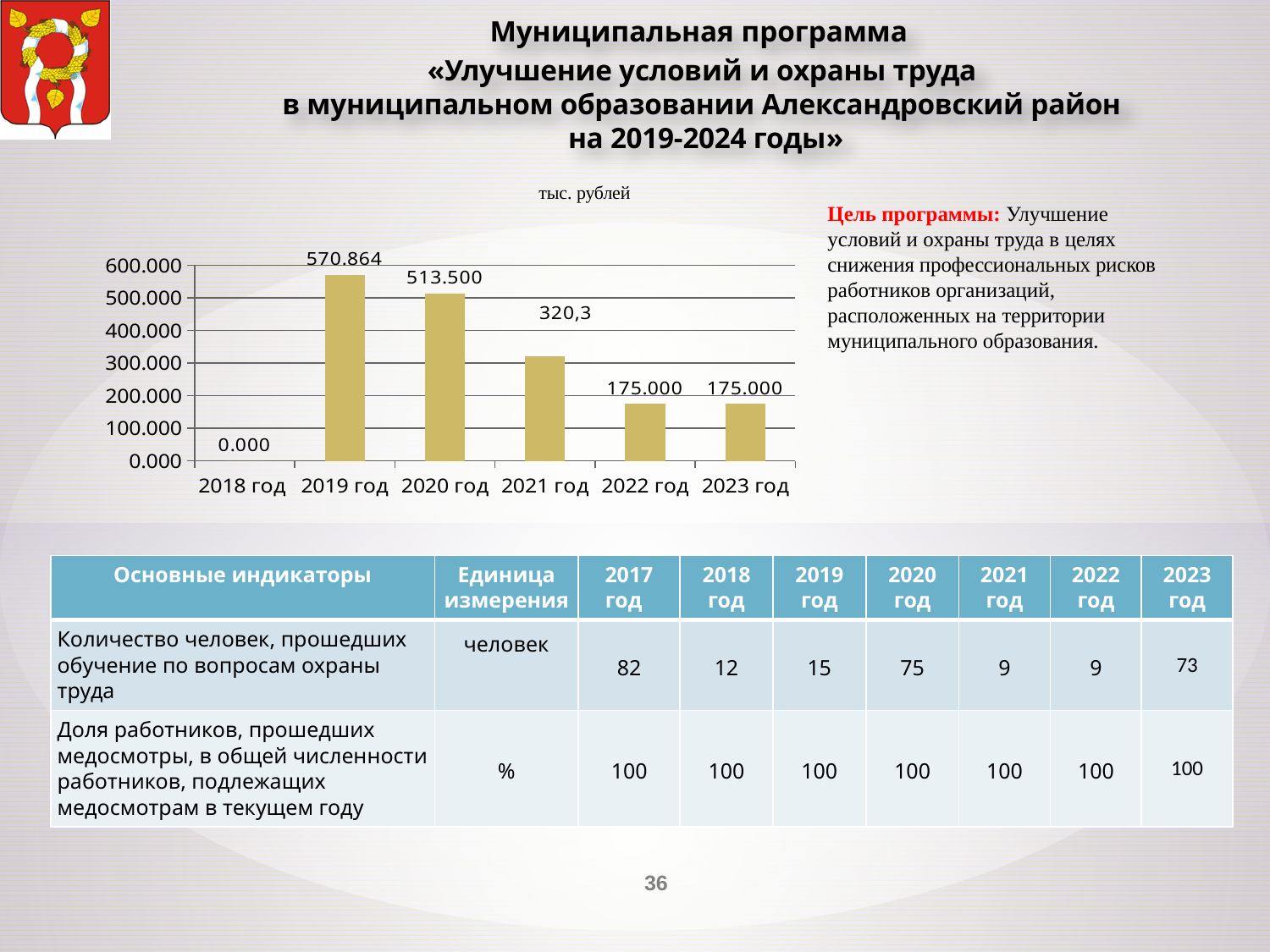
Is the value for 2021 год in the bar chart greater or less than 400.000? less Which year has the lowest value in the bar chart? 2018 год What is the value for 2021 год in the bar chart? 320,3 What kind of chart is shown on the slide? bar chart How many years are shown on the x axis of the bar chart? 6 What is the value for 2018 год in the bar chart? 0.000 What is the value for 2019 год in the bar chart? 570.864 What is the value for 2020 год in the bar chart? 513.500 What unit label is shown above the bar chart? тыс. рублей Which is larger in the bar chart, the value for 2020 год or the value for 2022 год? 2020 год What is the difference between the values for 2019 год and 2020 год in the bar chart? 57.364 Which year has the highest value in the bar chart? 2019 год